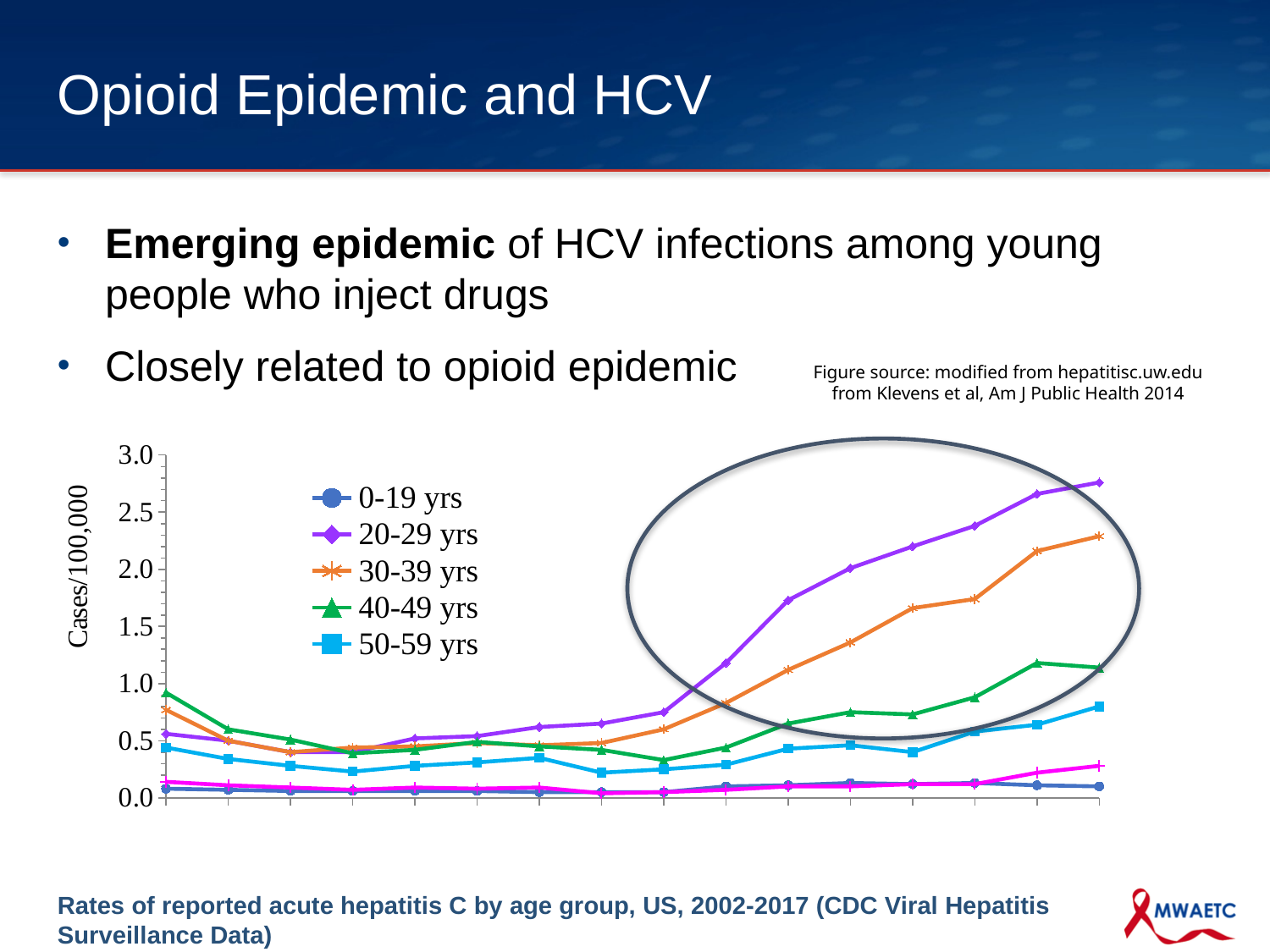
Is the final value for the 20-29 yrs series greater or less than 2.5? greater Is the final value for the 0-19 yrs series greater or less than 0.5? less What kind of chart is shown on the slide? Line chart What is the highest value shown on the chart's vertical axis? 3.0 Which age group has the highest value at the right end of the chart? 20-29 yrs At the right end of the chart, which is larger: the 30-39 yrs series or the 40-49 yrs series? 30-39 yrs Is the final value for the 50-59 yrs series greater or less than 1.0? less What is the label on the chart's vertical axis? Cases/100,000 Which legend age group has the lowest value at the right end of the chart? 0-19 yrs How many series does the chart's legend list? 5 Does the 20-29 yrs series rise or fall over the second half of the chart? Rise